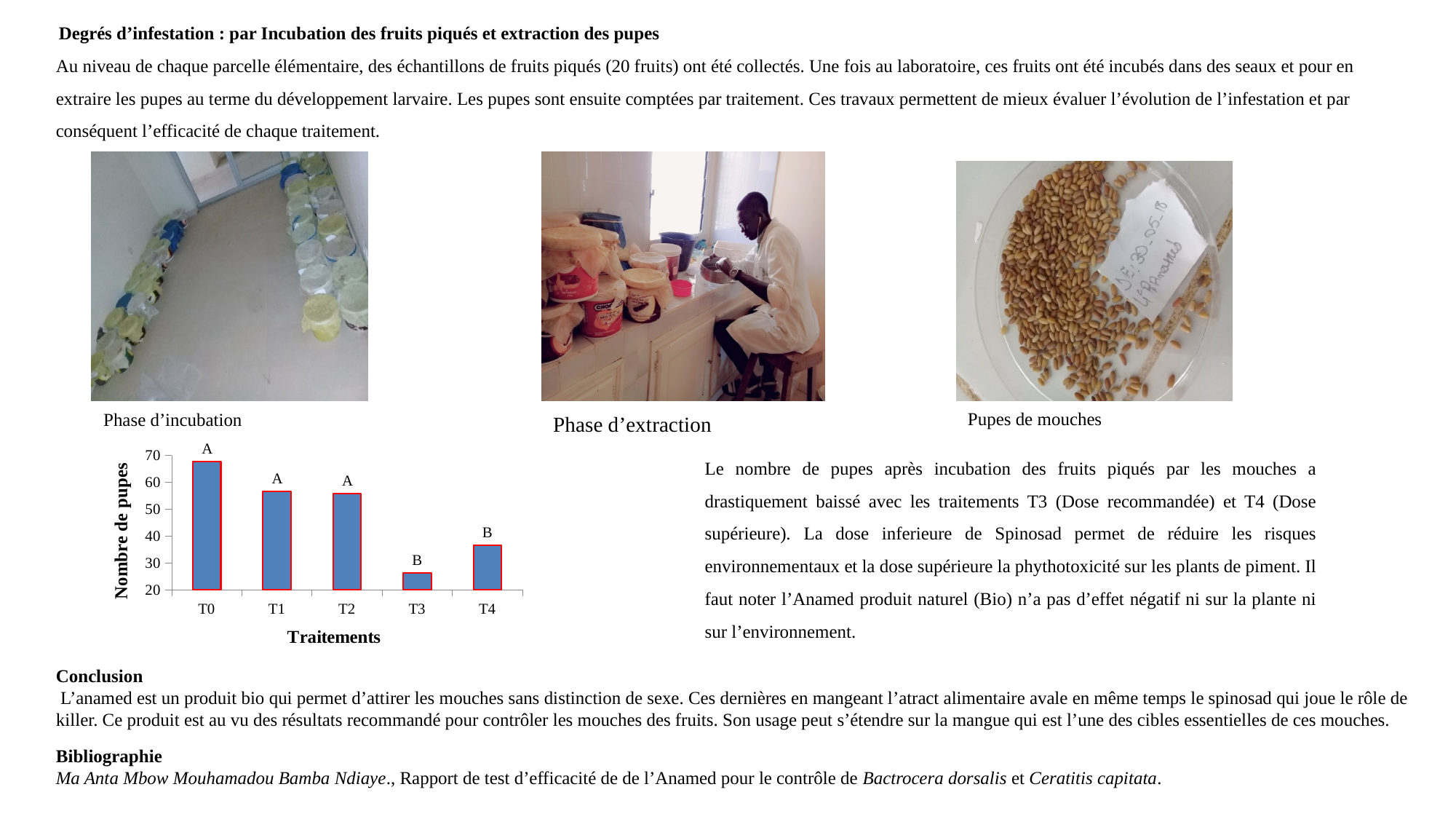
What letter is printed above the bar for T3? B How many treatments are plotted on the x axis of the chart? 5 Is the number of pupes for T4 greater or less than 30? greater Which has more pupes, T0 or T3? T0 What is the title of the y axis of the chart? Nombre de pupes Is the number of pupes for T0 greater or less than 60? greater Which has more pupes, T4 or T3? T4 Is the number of pupes for T1 greater or less than 50? greater Which treatment has the lowest number of pupes? T3 What kind of chart is shown on the slide? bar chart Which treatment has the highest number of pupes? T0